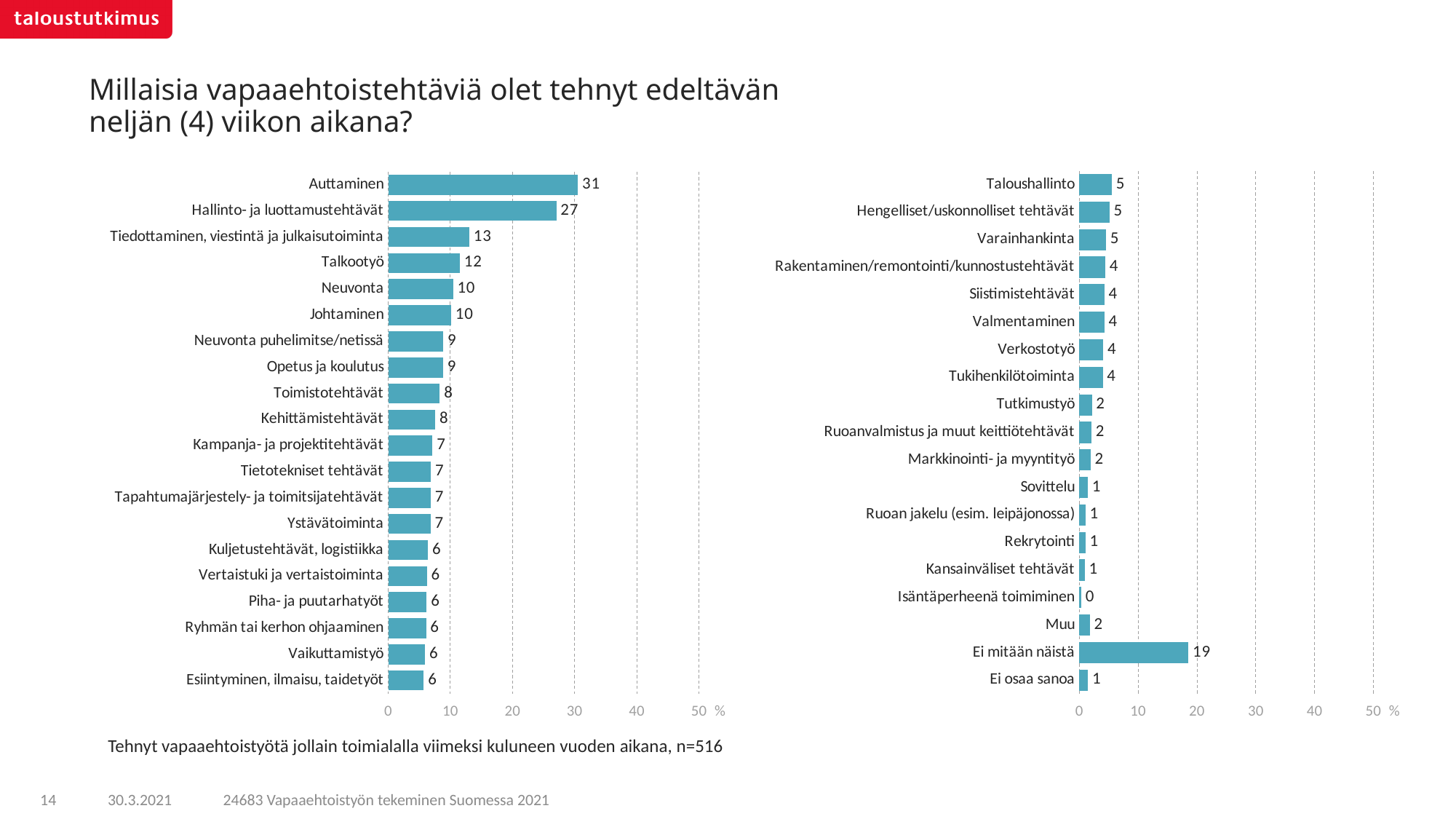
On the right chart, what is the value for Isäntäperheenä toimiminen? 0 On the left chart, what is the difference between Auttaminen and Hallinto- ja luottamustehtävät? 4 On the left chart, is the value for Tiedottaminen, viestintä ja julkaisutoiminta greater or less than 10? greater How many categories are shown on the right chart? 19 On the left chart, what is the value for Auttaminen? 31 On the left chart, which category has the highest value? Auttaminen On the right chart, which category has the lowest value? Isäntäperheenä toimiminen On the right chart, what is the value for Ei mitään näistä? 19 On the left chart, what is the value for Talkootyö? 12 How many categories are shown on the left chart? 20 What type of chart is the left chart? Bar chart On the right chart, which is larger: Taloushallinto or Tutkimustyö? Taloushallinto